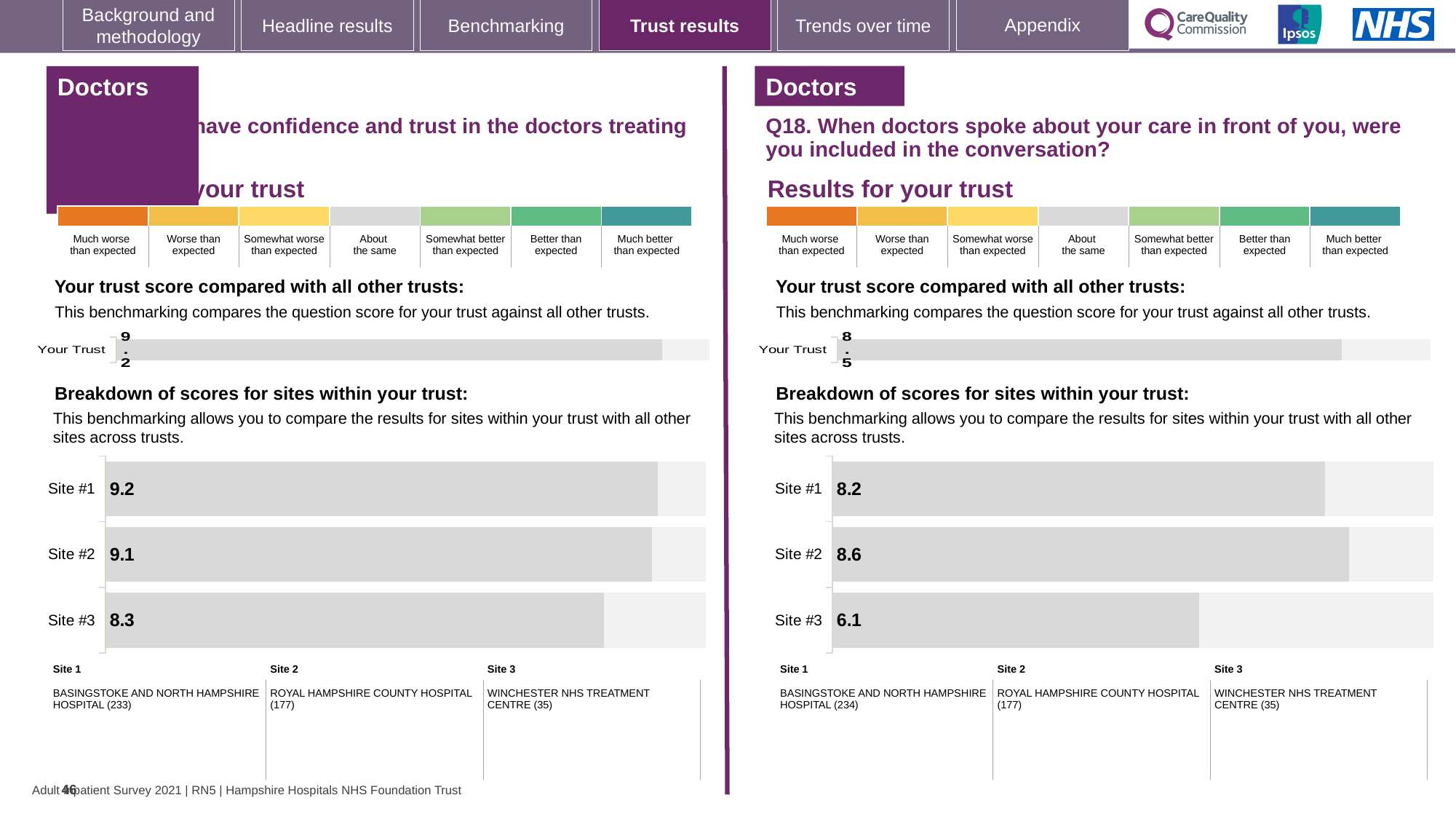
On the left-hand side, what is the 'Your Trust' score compared with all other trusts? 9.2 On the right-hand chart (Q18), what is the score for Site #2? 8.6 On the left-hand site breakdown chart, what is the difference between the scores for Site #1 and Site #3? 0.9 On the right-hand chart (Q18), which has the higher score, Site #1 or Site #2? Site #2 How many sites are shown in the left-hand site breakdown chart? 3 On the left-hand site breakdown chart, what is the score for Site #3? 8.3 On the right-hand chart (Q18), which site has the lowest score? Site #3 On the right-hand chart (Q18), do the site scores rise or fall from Site #2 to Site #3? Fall What type of chart is used for the site breakdown on the right-hand side (Q18)? Bar chart On the right-hand side (Q18), what is the 'Your Trust' score compared with all other trusts? 8.5 On the left-hand site breakdown chart, which site has the highest score? Site #1 On the right-hand chart (Q18), what is the difference between the scores for Site #2 and Site #3? 2.5